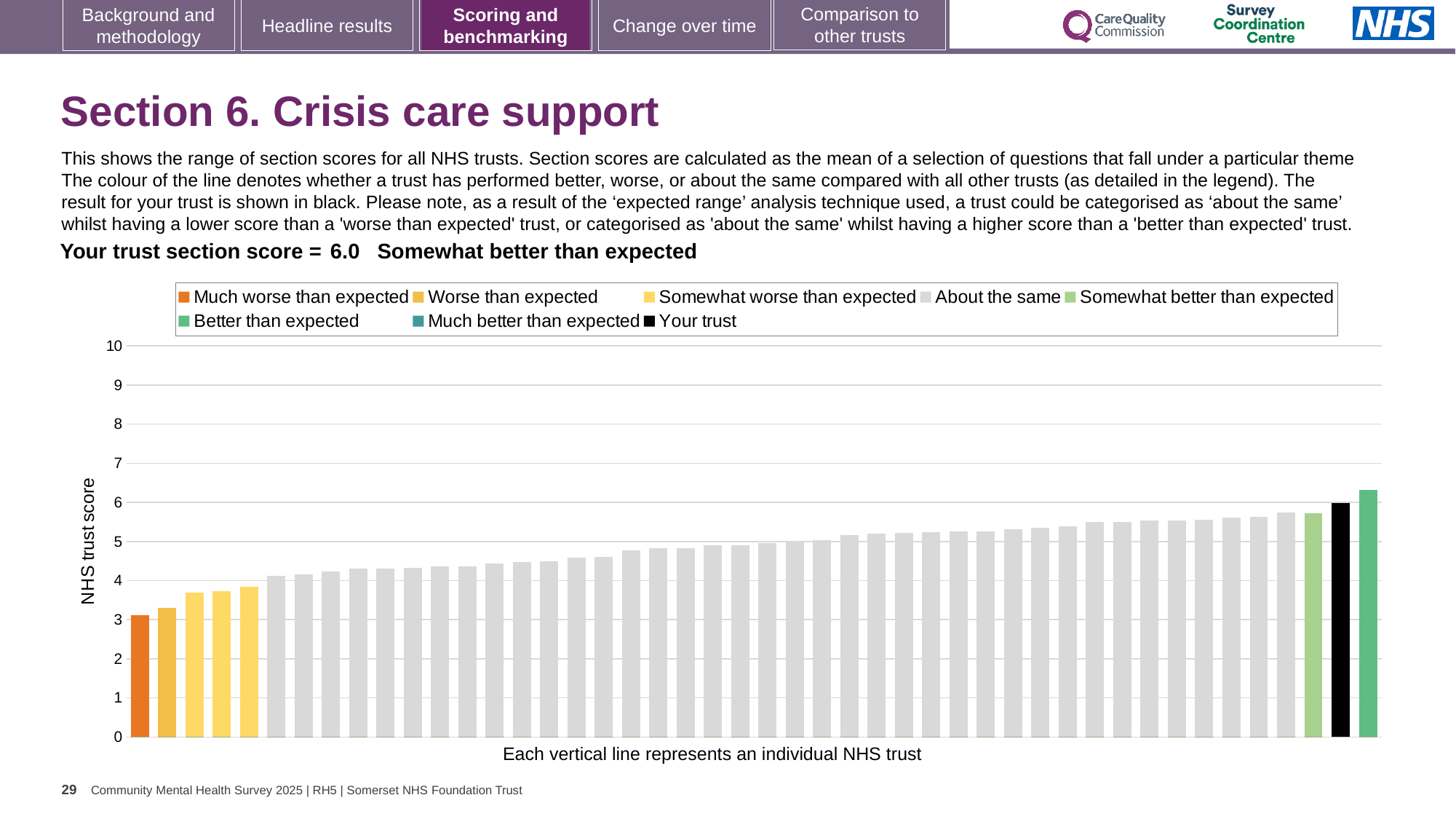
What colour is the bar for your trust? black Which is larger: the score for your trust (black bar) or the score for the orange 'Much worse than expected' trust? your trust What kind of chart is shown on the slide? bar chart How many bars are coloured as 'Much worse than expected'? 1 Is the value of the lowest bar (the orange 'Much worse than expected' trust) greater or less than 4? less What is the section score for your trust shown on the slide? 6.0 What is the label on the vertical axis of the chart? NHS trust score How many entries does the chart legend list? 8 Is the value for your trust (the black bar) greater or less than 5? greater Is the value of the tallest bar in the chart greater or less than 5? greater Which legend category does the tallest bar in the chart belong to? Better than expected Do the bar values rise or fall from left to right across the chart? rise